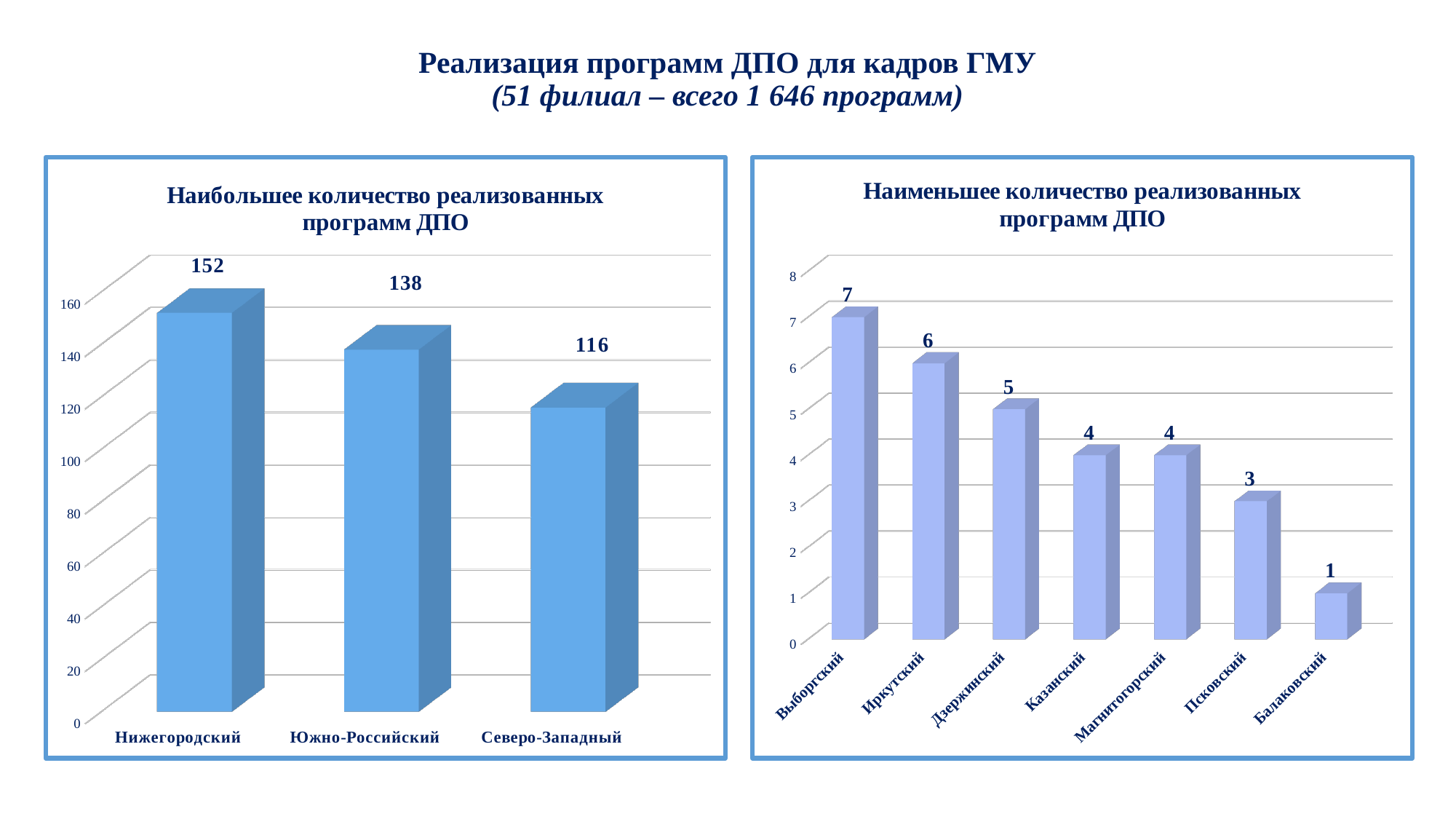
In the left chart (Наибольшее количество реализованных программ ДПО), how many categories are shown? 3 In the right chart (Наименьшее количество реализованных программ ДПО), how many categories are shown? 7 In the left chart (Наибольшее количество реализованных программ ДПО), which category has the lowest value? Северо-Западный In the right chart (Наименьшее количество реализованных программ ДПО), what is the value for Псковский? 3 In the right chart (Наименьшее количество реализованных программ ДПО), which category has the lowest value? Балаковский In the left chart (Наибольшее количество реализованных программ ДПО), what is the difference between Нижегородский and Южно-Российский? 14 In the left chart (Наибольшее количество реализованных программ ДПО), what is the value for Северо-Западный? 116 What kind of chart is the right chart (Наименьшее количество реализованных программ ДПО)? Bar chart In the right chart (Наименьшее количество реализованных программ ДПО), which is larger: Дзержинский or Магнитогорский? Дзержинский In the left chart (Наибольшее количество реализованных программ ДПО), what is the value for Нижегородский? 152 In the right chart (Наименьшее количество реализованных программ ДПО), which category has the highest value? Выборгский In the right chart (Наименьшее количество реализованных программ ДПО), what is the value for Иркутский? 6